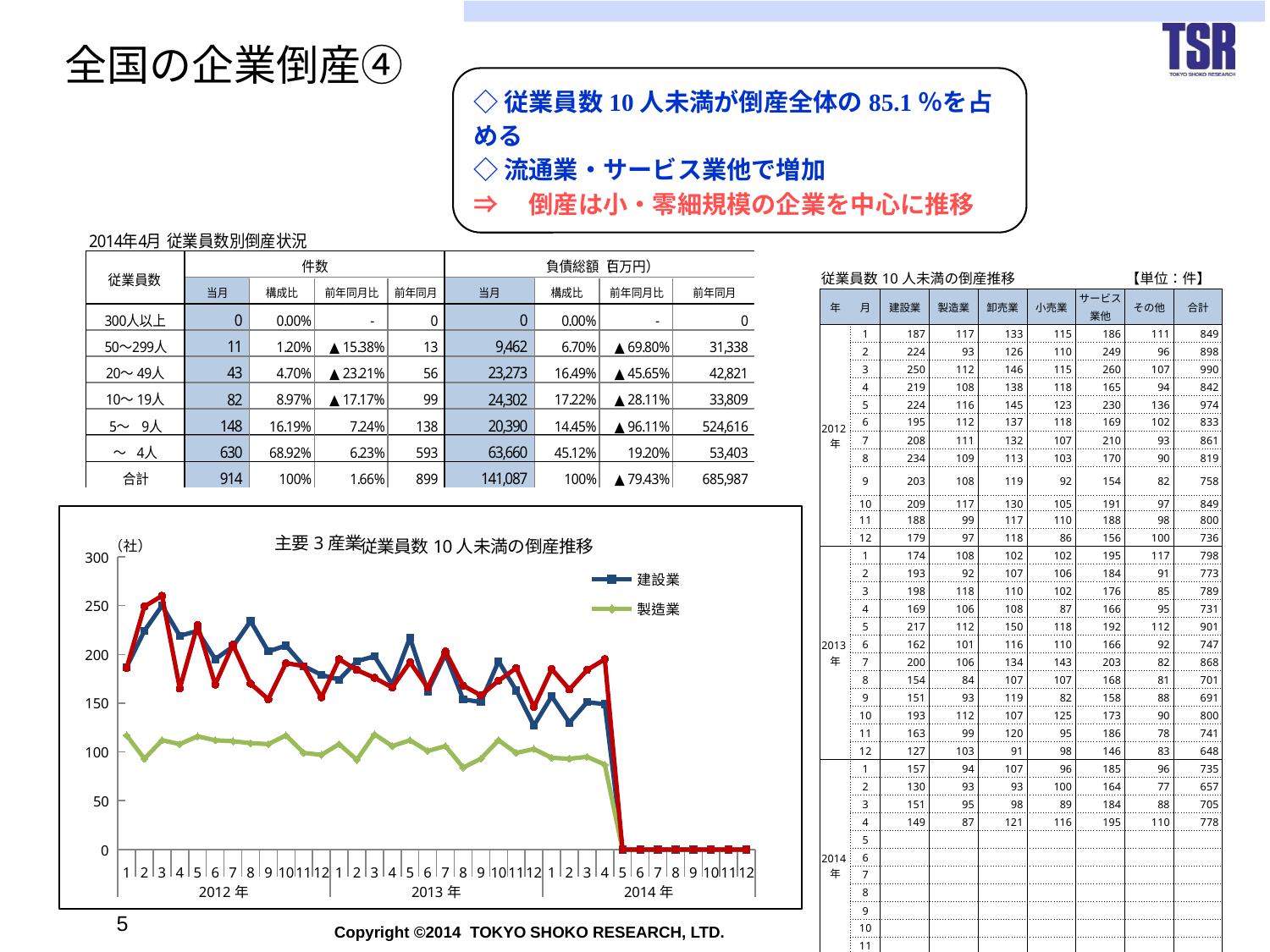
Is the value for 建設業 in month 3 of 2012 greater or less than 200? greater What unit label is shown at the top of the chart's vertical axis? (社) Is the value for 製造業 in month 1 of 2012 greater or less than 150? less What is the highest tick value shown on the chart's vertical axis? 300 What kind of chart is shown on the slide? line chart How many years are labelled along the chart's x axis? 3 In month 1 of 2012, which series has the larger value, 建設業 or 製造業? 建設業 Which two series are named in the chart legend? 建設業 and 製造業 Does the 建設業 line generally rise or fall from early 2012 to early 2014? fall Is the value for 製造業 in month 5 of 2013 greater or less than 150? less How many series does the chart legend list? 2